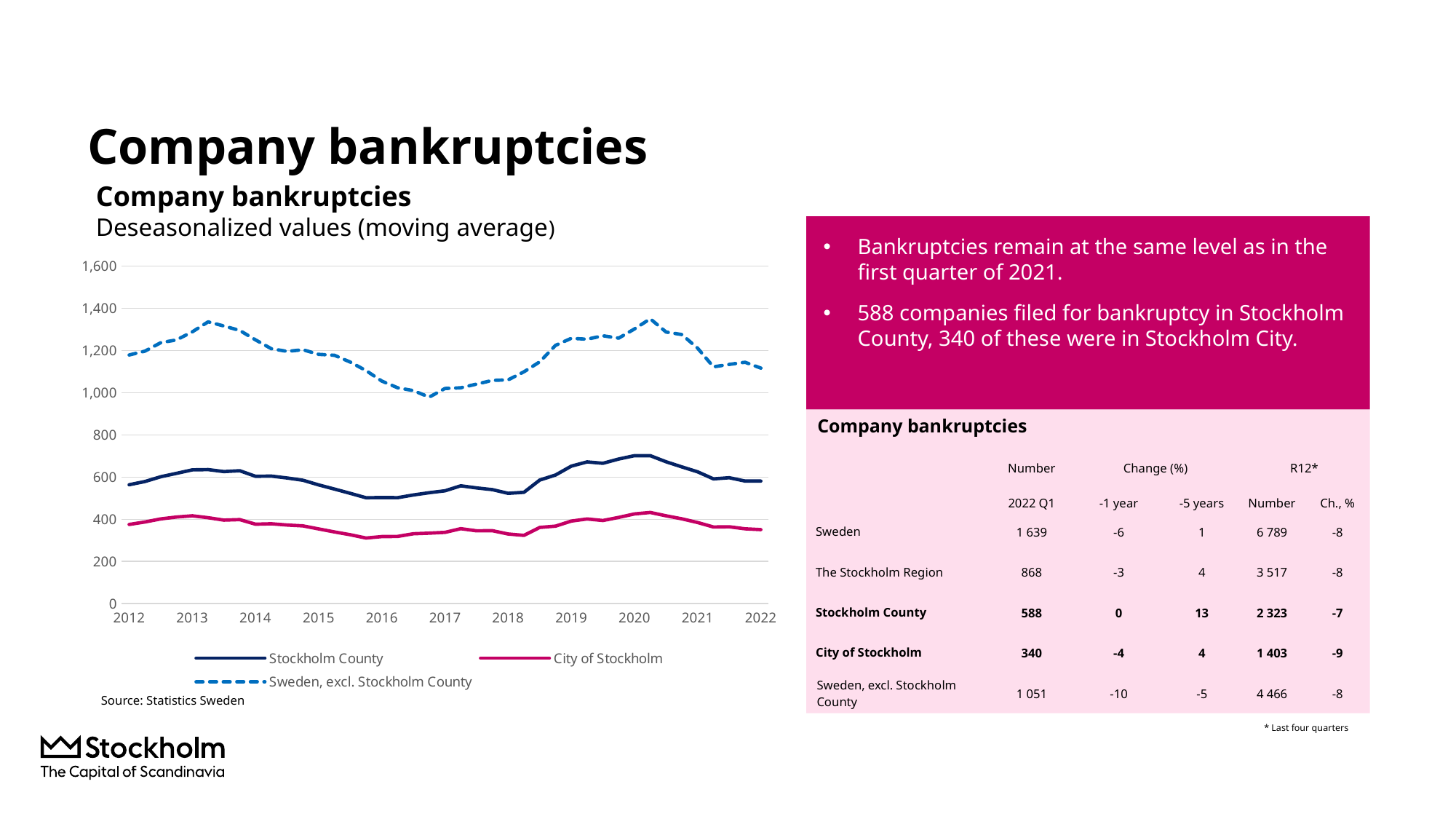
What is the subtitle of the chart below 'Company bankruptcies'? Deseasonalized values (moving average) In 2020, which is larger: the value for Stockholm County or the value for City of Stockholm? Stockholm County Which series is plotted with a dashed line? Sweden, excl. Stockholm County Does the Sweden, excl. Stockholm County line rise or fall between 2013 and 2016? fall Is the value for City of Stockholm in 2022 greater or less than 400? less How many series does the chart legend list? 3 Which series has the highest values throughout the chart? Sweden, excl. Stockholm County Which series has the lowest values throughout the chart? City of Stockholm Is the value for Sweden, excl. Stockholm County at its 2013 peak greater or less than 1,200? greater Is the value for Stockholm County at its 2020 peak greater or less than 600? greater What kind of chart is shown on the slide? Line chart